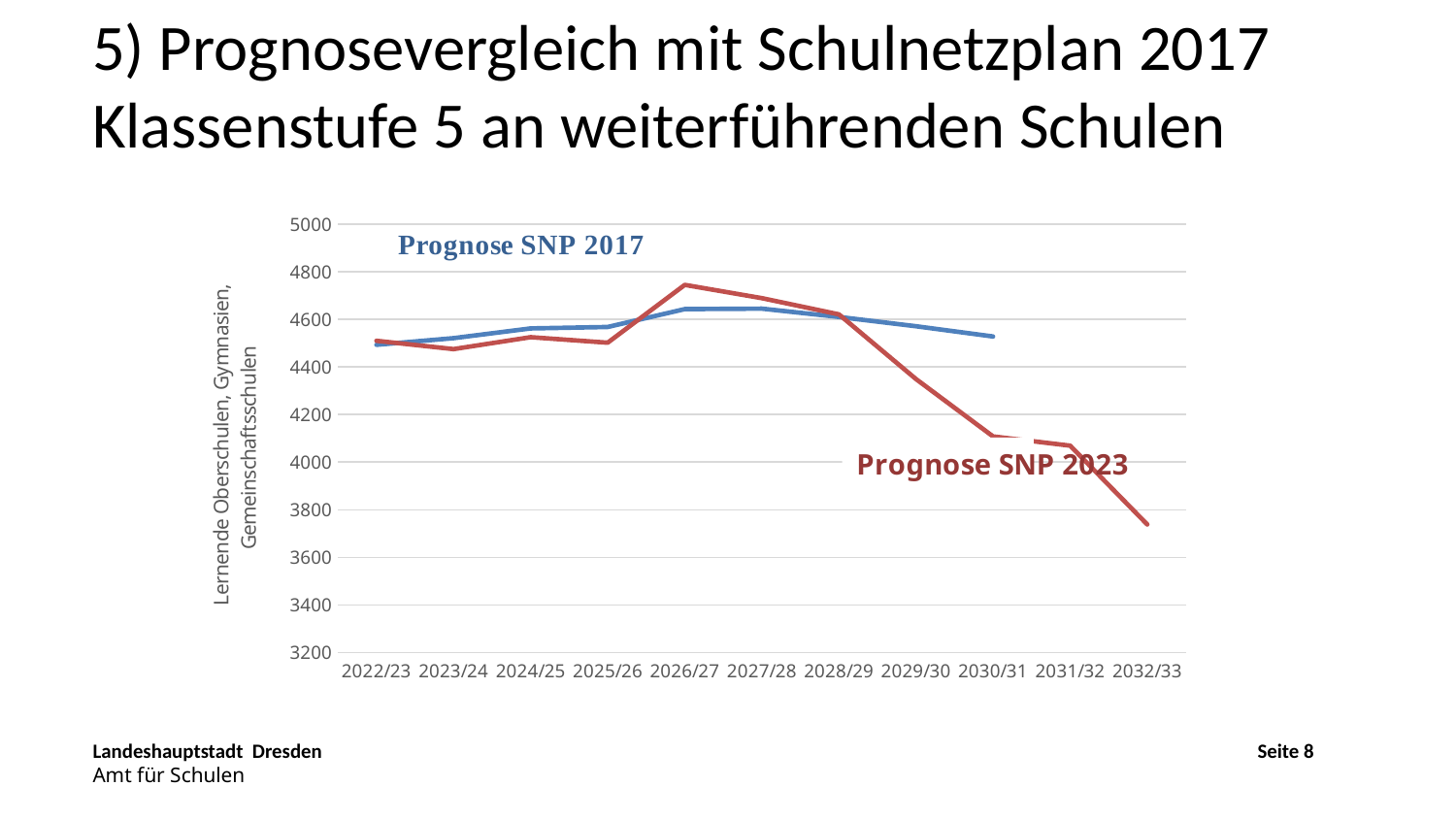
What is the first school year shown on the x axis? 2022/23 In which school year does the Prognose SNP 2023 line reach its lowest value? 2032/33 What kind of chart is shown on the slide? line chart How many series (prognoses) are plotted in the chart? 2 Which series is drawn in red? Prognose SNP 2023 Is the value of Prognose SNP 2017 for 2030/31 greater or less than 4600? less In which school year does the Prognose SNP 2023 line reach its highest value? 2026/27 In 2030/31, which series has the higher value, Prognose SNP 2017 or Prognose SNP 2023? Prognose SNP 2017 Is the value of Prognose SNP 2023 for 2026/27 greater or less than 4600? greater How many school years are shown on the x axis of the chart? 11 Does the Prognose SNP 2023 line rise or fall from 2028/29 to 2032/33? fall Is the value of Prognose SNP 2023 for 2032/33 greater or less than 3800? less